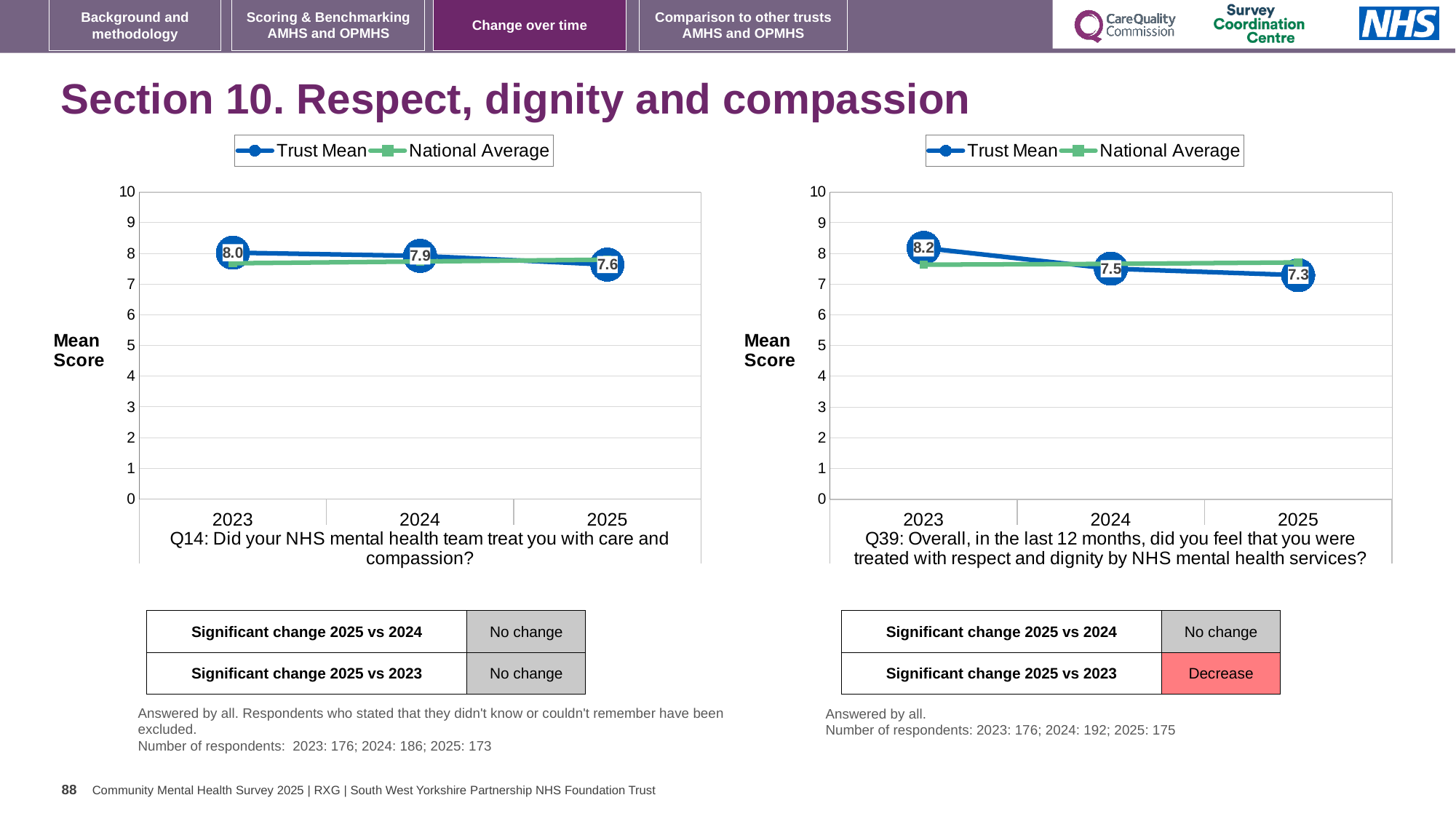
In the right chart (Q39), what is the Trust Mean for 2024? 7.5 In the right chart (Q39), what is the Trust Mean for 2023? 8.2 In the left chart (Q14), what is the difference between the Trust Mean for 2023 and 2025? 0.4 In the left chart (Q14), what is the Trust Mean for 2025? 7.6 In the right chart (Q39), which year has the lowest Trust Mean? 2025 In the right chart (Q39), does the Trust Mean rise or fall from 2023 to 2025? Fall Which is larger: the 2025 Trust Mean in the left chart (Q14) or the 2025 Trust Mean in the right chart (Q39)? Left chart (Q14), 7.6 In the right chart (Q39), what is the difference between the Trust Mean for 2023 and 2025? 0.9 In the left chart (Q14), what is the Trust Mean for 2023? 8.0 What type of chart is used on this slide? Line chart How many series does the legend of the left chart list? 2 In the left chart (Q14), which year has the highest Trust Mean? 2023